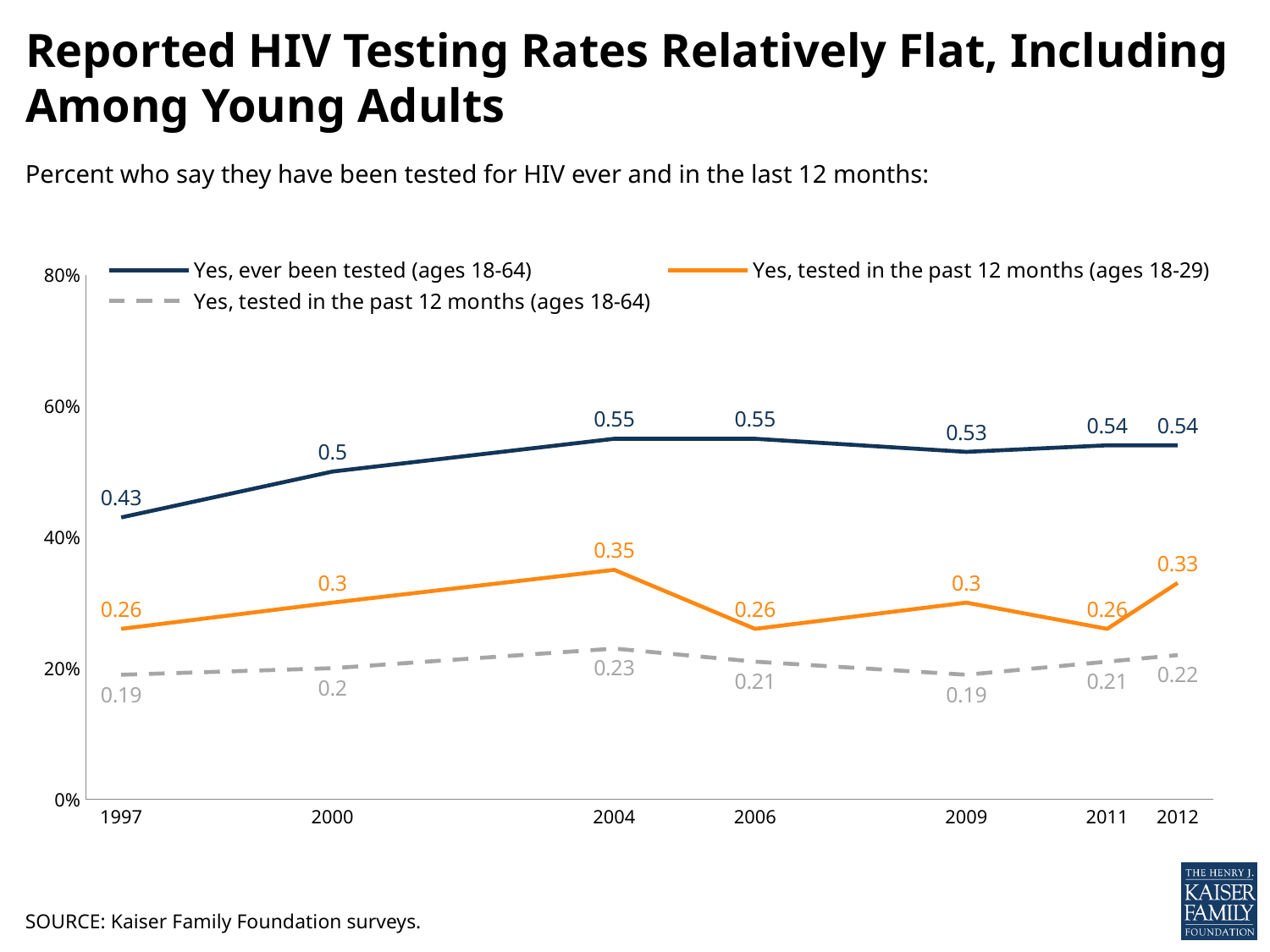
What is the difference between the 'Yes, ever been tested (ages 18-64)' values in 2004 and 1997? 0.12 In which year is the 'Yes, tested in the past 12 months (ages 18-29)' series at its highest? 2004 Does the 'Yes, ever been tested (ages 18-64)' series rise or fall from 1997 to 2004? rise What is the title of the chart on the slide? Reported HIV Testing Rates Relatively Flat, Including Among Young Adults How many years are plotted along the x axis? 7 What is the value for 'Yes, tested in the past 12 months (ages 18-29)' in 2004? 0.35 How many series does the legend list? 3 What is the value for 'Yes, tested in the past 12 months (ages 18-64)' in 2012? 0.22 What type of chart is shown on the slide? line chart In which year is the 'Yes, ever been tested (ages 18-64)' series at its lowest? 1997 What is the value for 'Yes, ever been tested (ages 18-64)' in 1997? 0.43 Which is larger in 2009: the value for 'Yes, tested in the past 12 months (ages 18-29)' or for 'Yes, tested in the past 12 months (ages 18-64)'? Yes, tested in the past 12 months (ages 18-29)